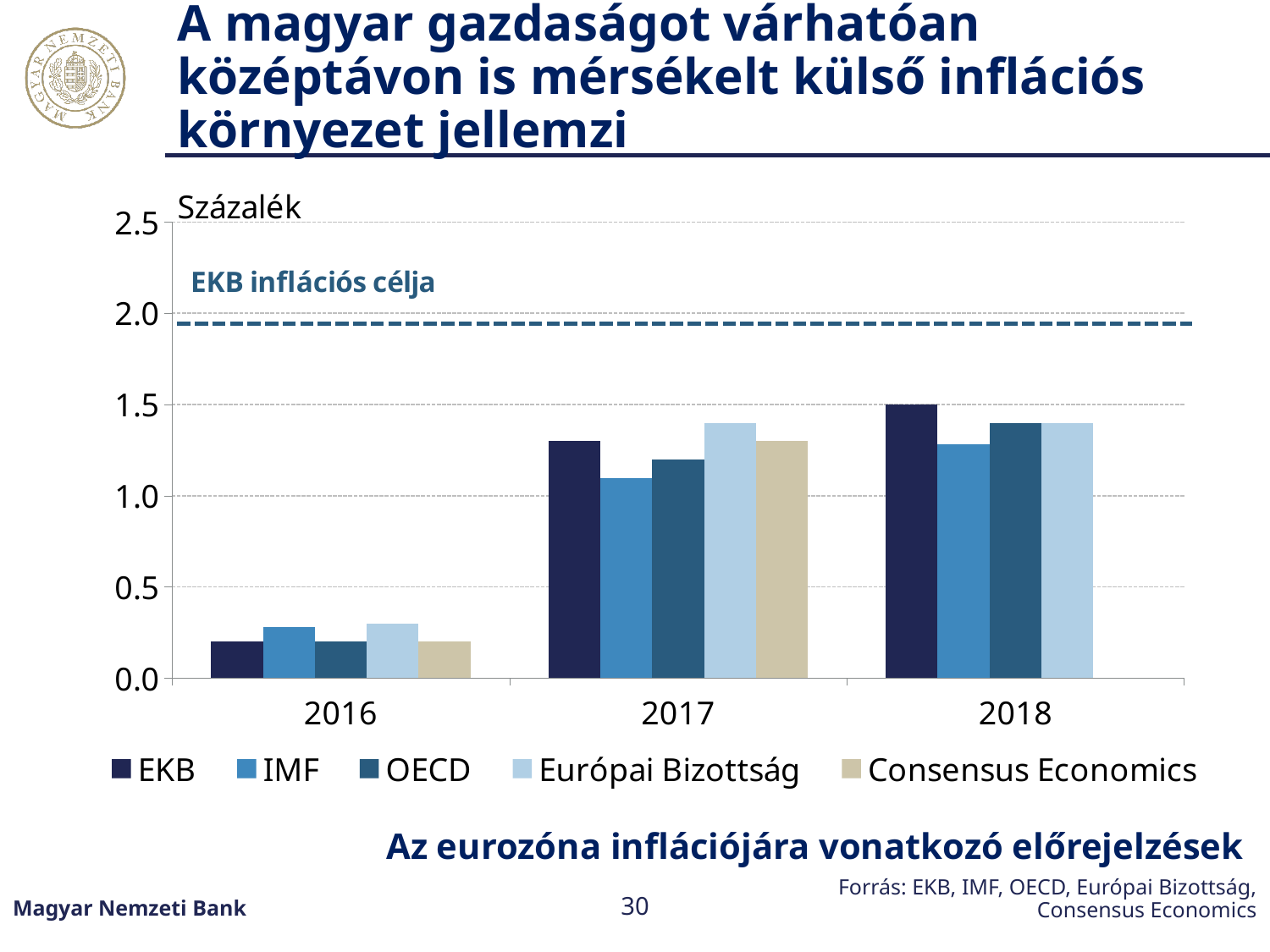
How many year categories are shown on the x axis? 3 Is the EKB value for 2017 greater or less than 1.0? greater What does the horizontal dashed line on the chart represent, according to its label? EKB inflációs célja What kind of chart is shown on the slide? bar chart Which series has the lowest value for 2017? IMF How many series does the legend list? 5 Do the EKB forecast values rise or fall from 2016 to 2018? rise For 2017, which is larger: the EKB value or the IMF value? EKB Is the IMF value for 2016 greater or less than 0.5? less What is the title of the chart shown below the legend? Az eurozóna inflációjára vonatkozó előrejelzések Is the IMF value for 2018 greater or less than 1.5? less Which series has the highest value for 2017? Európai Bizottság